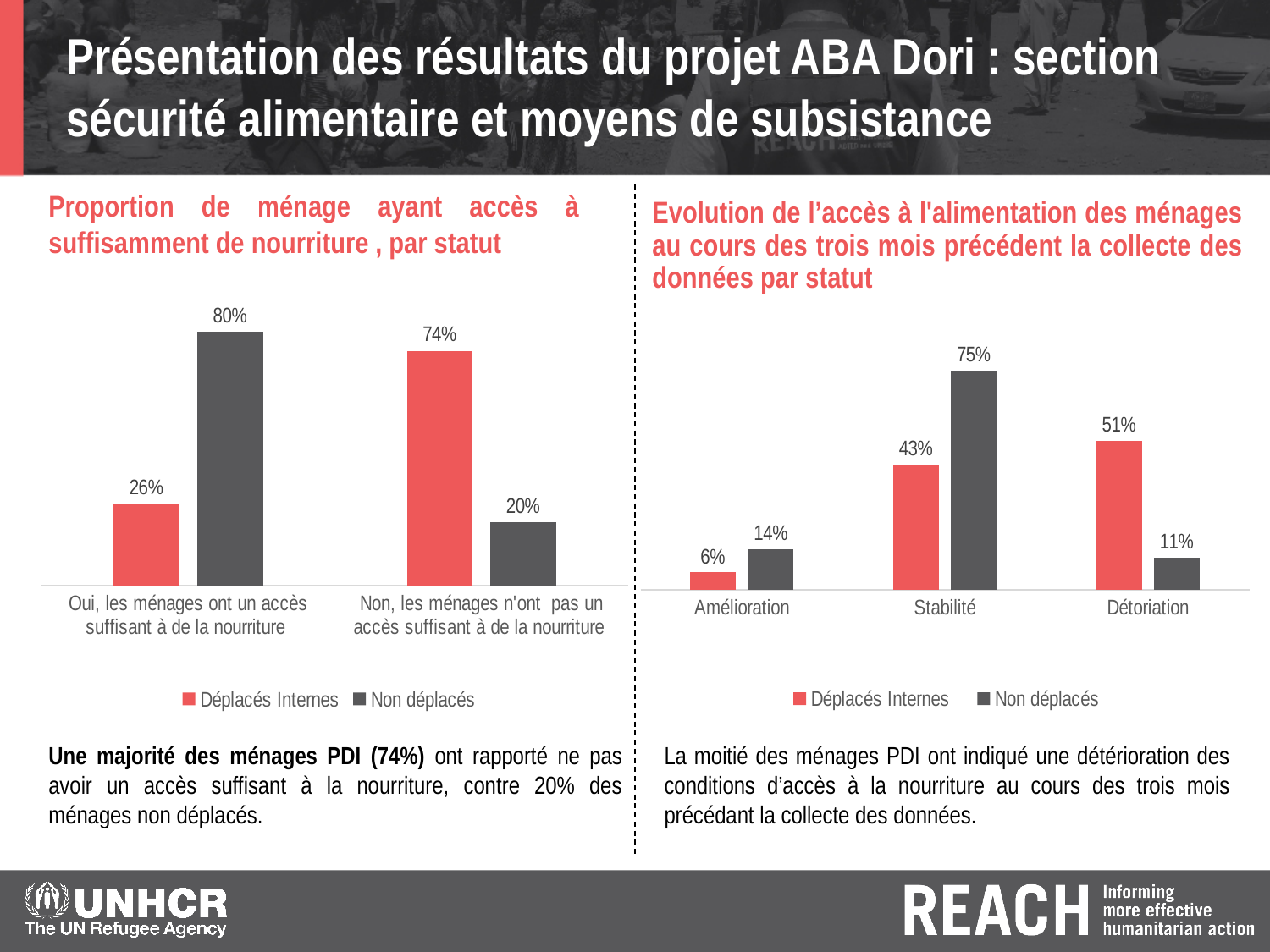
In the left chart (Proportion de ménage ayant accès à suffisamment de nourriture, par statut), which series has the larger value for 'Non, les ménages n'ont pas un accès suffisant à de la nourriture'? Déplacés Internes In the left chart (Proportion de ménage ayant accès à suffisamment de nourriture, par statut), what is the value for Déplacés Internes in the category 'Non, les ménages n'ont pas un accès suffisant à de la nourriture'? 74% What kind of chart is the left chart (Proportion de ménage ayant accès à suffisamment de nourriture, par statut)? Bar chart In the left chart (Proportion de ménage ayant accès à suffisamment de nourriture, par statut), what is the difference between the Non déplacés and Déplacés Internes values for 'Oui, les ménages ont un accès suffisant à de la nourriture'? 54% In the right chart (Evolution de l'accès à l'alimentation des ménages), which category has the lowest value for Déplacés Internes? Amélioration How many categories are shown on the x axis of the right chart (Evolution de l'accès à l'alimentation des ménages)? 3 In the right chart (Evolution de l'accès à l'alimentation des ménages), what is the value for Déplacés Internes in the Détoriation category? 51% In the right chart (Evolution de l'accès à l'alimentation des ménages), which category has the highest value for Non déplacés? Stabilité In the left chart (Proportion de ménage ayant accès à suffisamment de nourriture, par statut), what is the value for Non déplacés in the category 'Oui, les ménages ont un accès suffisant à de la nourriture'? 80% In the right chart (Evolution de l'accès à l'alimentation des ménages), what is the value for Non déplacés in the Stabilité category? 75% In the left chart (Proportion de ménage ayant accès à suffisamment de nourriture, par statut), how many series does the legend list? 2 In the right chart (Evolution de l'accès à l'alimentation des ménages), what is the difference between the Déplacés Internes and Non déplacés values for Détoriation? 40%